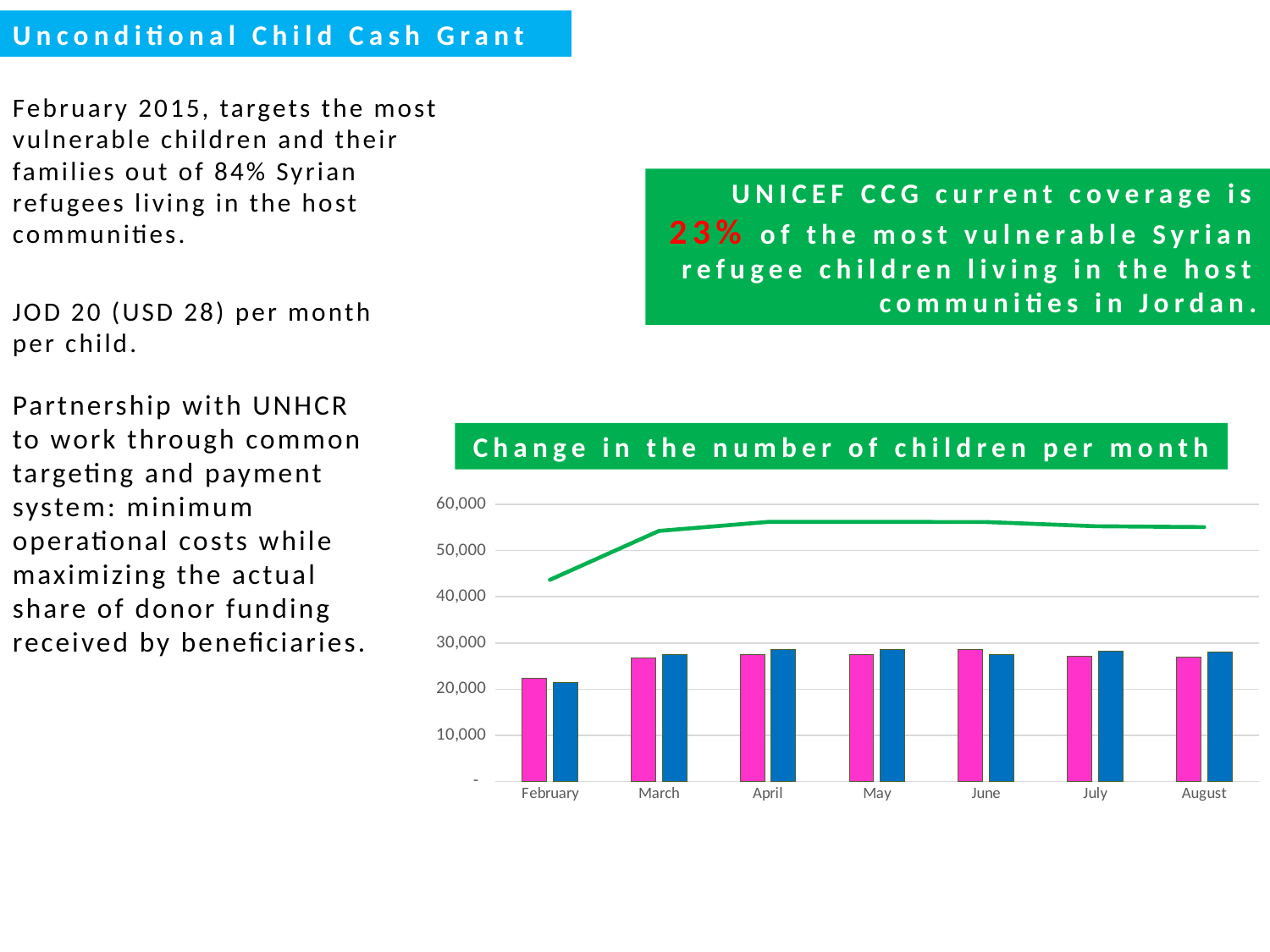
Which month has the lowest value on the green line? February Is the green line value for February greater or less than 50,000? less Is the pink bar for June greater or less than 30,000? less How many months are shown on the x axis of the chart? 7 Which month has the lowest pink bar? February Which is larger, the pink bar for February or the pink bar for March? March Is the pink bar for February greater or less than 30,000? less What kind of chart is shown under the title 'Change in the number of children per month'? A combined bar and line chart Does the green line rise or fall from February to March? rises What is the title of the chart on the slide? Change in the number of children per month